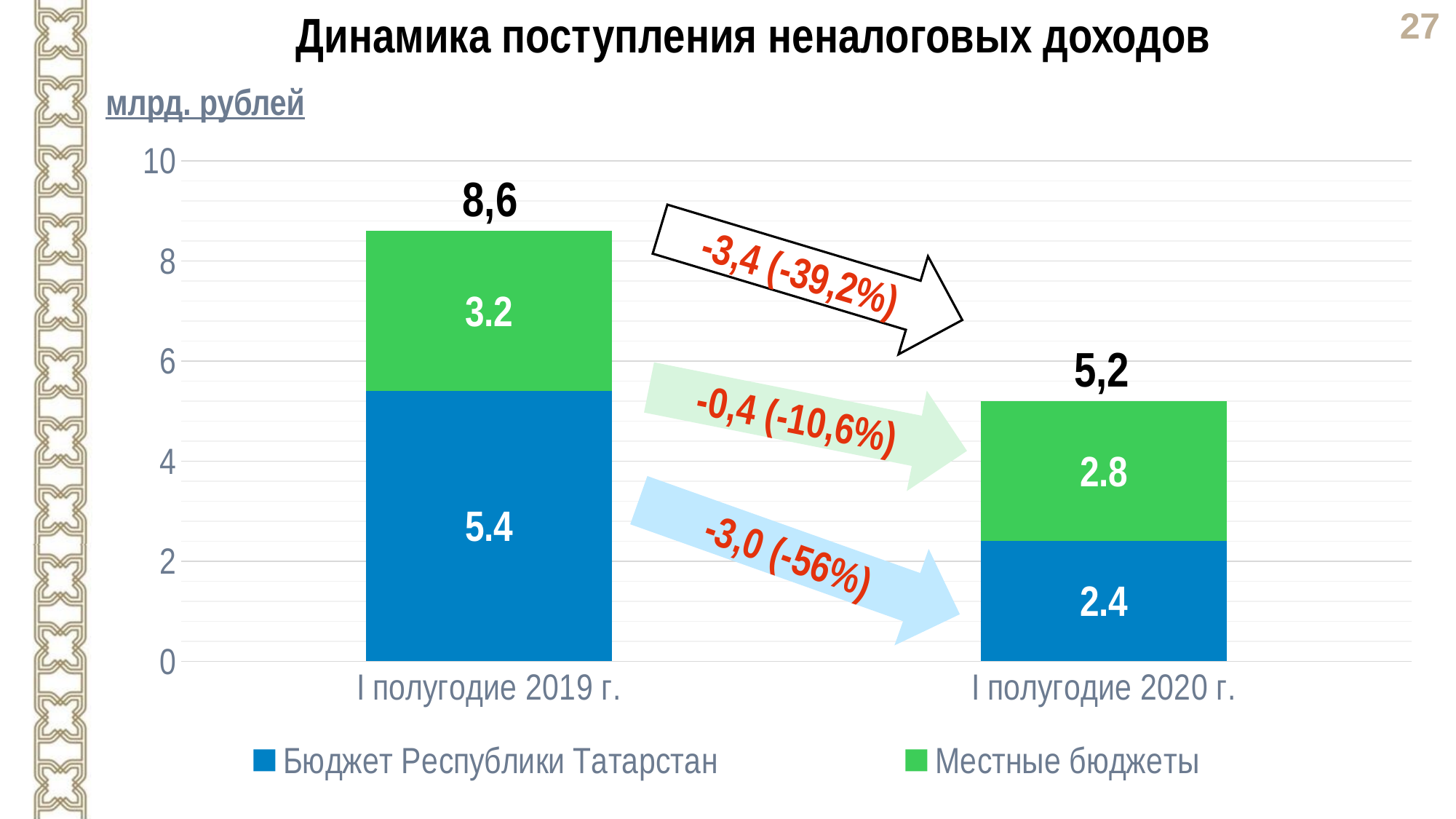
What is the value for Местные бюджеты in I полугодие 2020 г.? 2.8 What is the total of the stacked bar for I полугодие 2019 г.? 8,6 Do the total values rise or fall from I полугодие 2019 г. to I полугодие 2020 г.? Fall What is the value for Бюджет Республики Татарстан in I полугодие 2019 г.? 5.4 How many series does the legend list? 2 What is the total of the stacked bar for I полугодие 2020 г.? 5,2 What is the value for Бюджет Республики Татарстан in I полугодие 2020 г.? 2.4 What is the difference between the Бюджет Республики Татарстан values for I полугодие 2019 г. and I полугодие 2020 г.? 3.0 How many categories are shown on the x axis? 2 Which category has the higher total, I полугодие 2019 г. or I полугодие 2020 г.? I полугодие 2019 г. What unit is stated for the chart values? млрд. рублей What type of chart is shown on the slide? Stacked bar chart